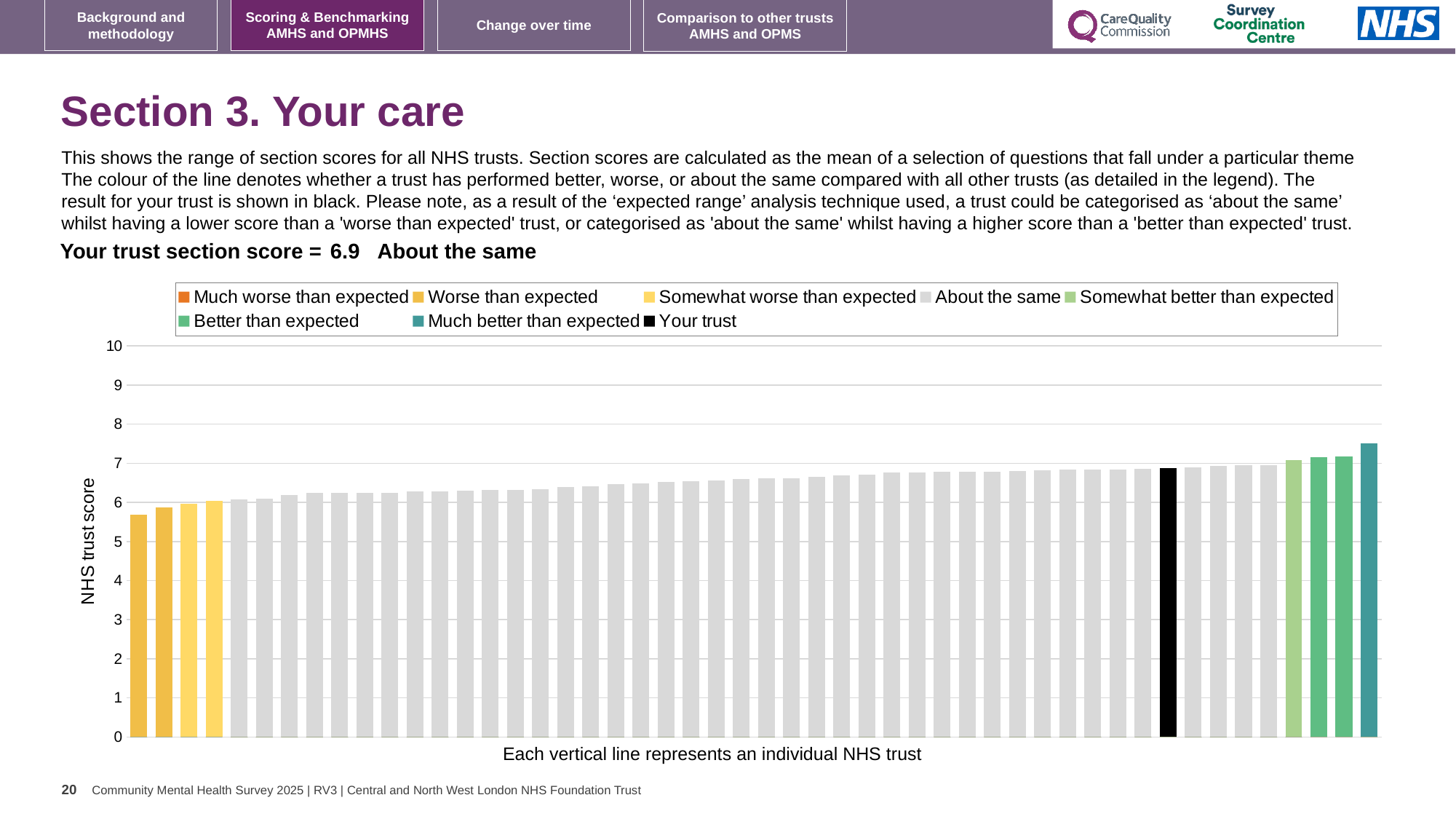
What is the highest value shown on the vertical axis? 10 What kind of chart is shown on the slide? bar chart Is the value of the lowest bar in the chart greater or less than 5? greater What is the section score for your trust shown on the slide? 6.9 How many black bars are there in the chart? 1 Do the bar values rise or fall from left to right along the x axis? rise Is the value of the highest bar in the chart greater or less than 7? greater Which category is your trust placed in for Section 3. Your care? About the same What is the label on the vertical axis of the chart? NHS trust score How many entries does the chart legend list? 8 Is the value of the black bar (your trust) greater or less than 6? greater What colour is the bar representing your trust? black